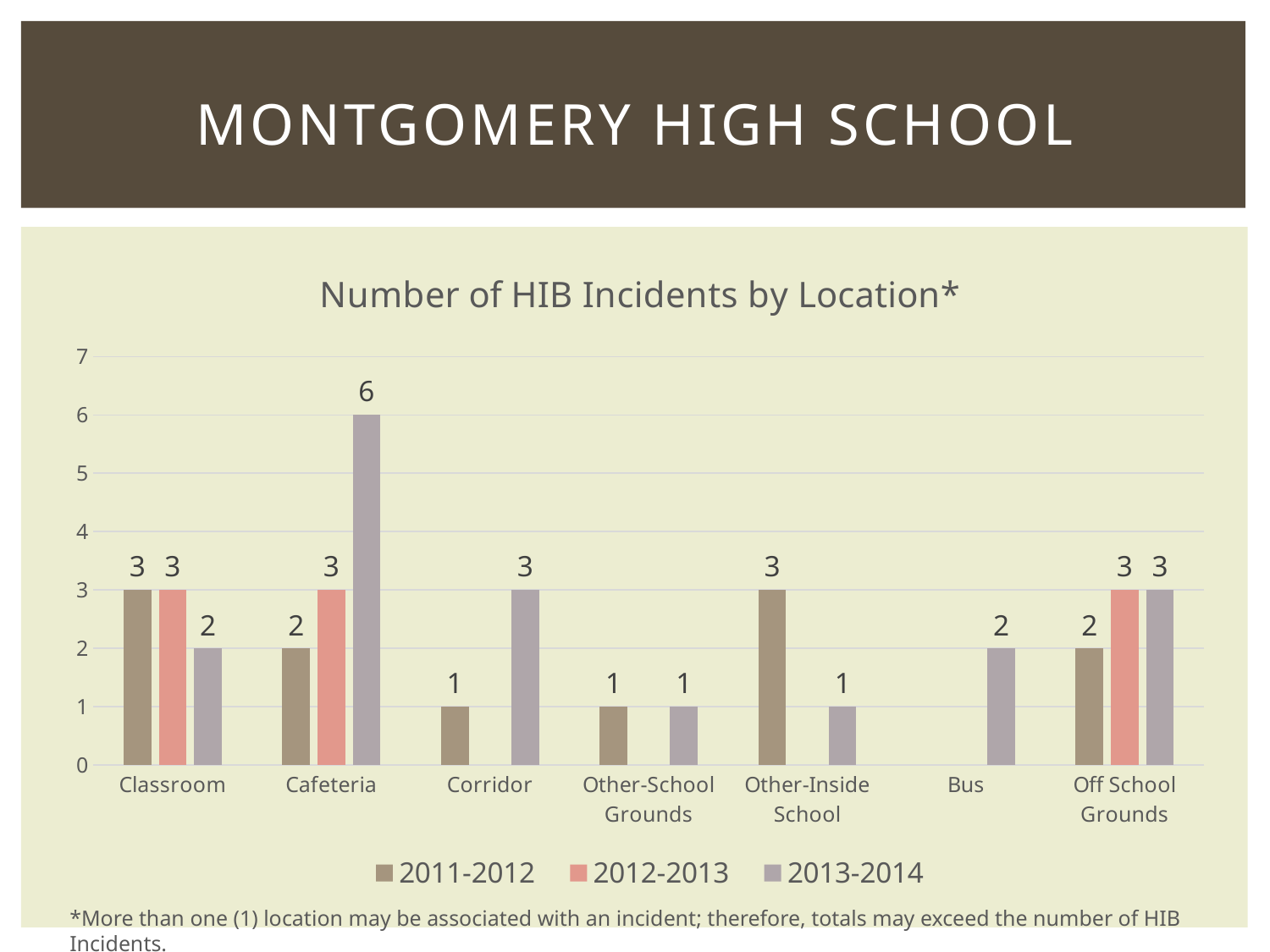
How many series does the legend list? 3 What is the value for Classroom in the 2011-2012 series? 3 What is the value for Off School Grounds in the 2012-2013 series? 3 How many location categories are shown on the x axis? 7 What is the value for Cafeteria in the 2013-2014 series? 6 Which is larger: the 2011-2012 value for Other-Inside School or the 2013-2014 value for Other-Inside School? 2011-2012 What is the title of the chart? Number of HIB Incidents by Location* What is the value for Bus in the 2013-2014 series? 2 Which location has the lowest value in the 2011-2012 series among those with a bar shown? Corridor and Other-School Grounds (both 1) What is the difference between the 2013-2014 value for Cafeteria and the 2013-2014 value for Classroom? 4 What kind of chart is shown on the slide? Bar chart Which location has the highest value in the 2013-2014 series? Cafeteria